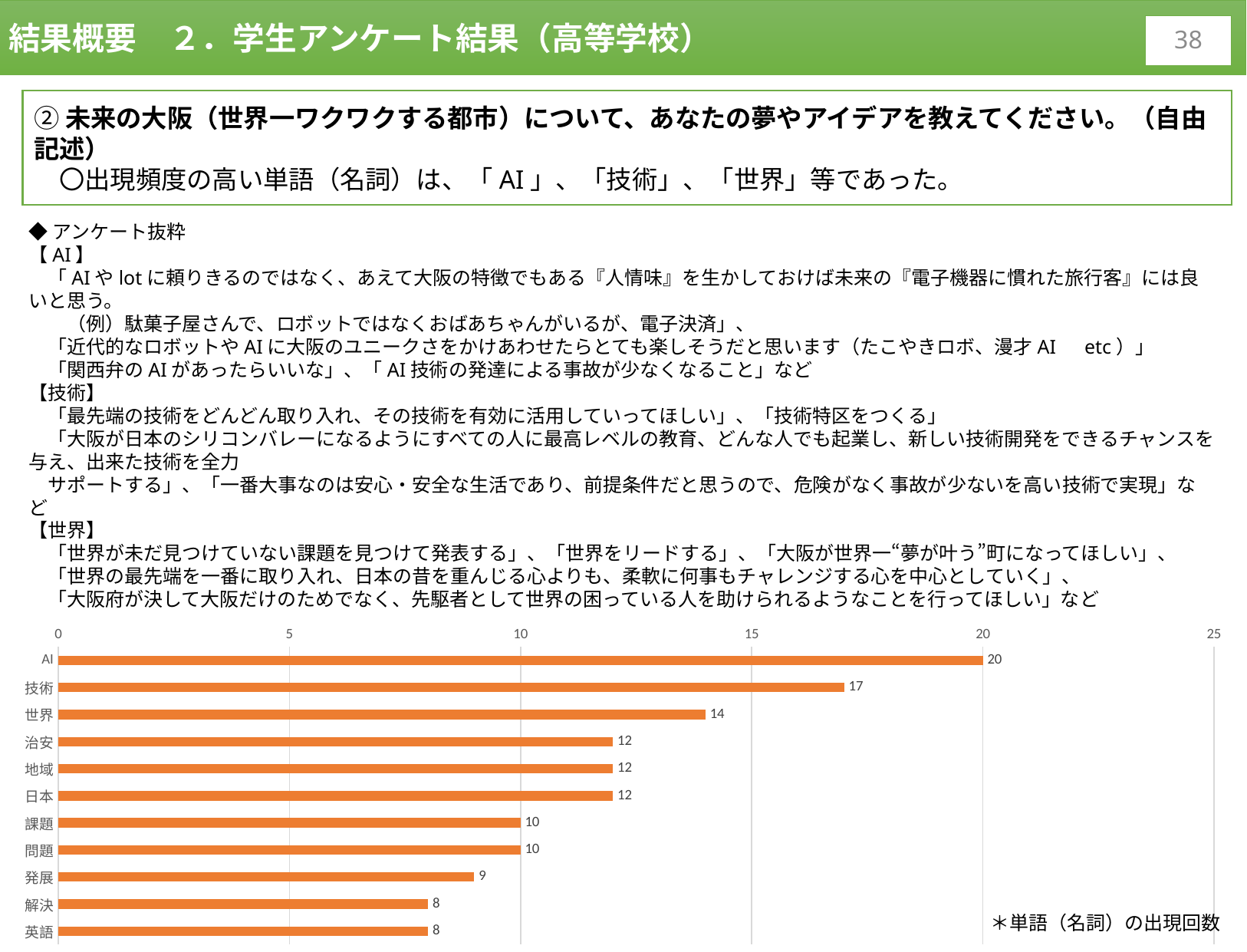
What is the value for AI in the bar chart? 20 What is the difference between the values for AI and 世界? 6 Which category has the highest value in the bar chart? AI How many categories are shown in the bar chart? 11 Which is larger, the value for 課題 or the value for 発展? 課題 What is the value for 発展 in the bar chart? 9 What is the difference between the values for 技術 and 解決? 9 What kind of chart is shown on the slide? bar chart What colour are the bars in the chart? orange Is the value for 技術 greater or less than 15? greater What is the value for 技術 in the bar chart? 17 Which is larger, the value for 世界 or the value for 治安? 世界